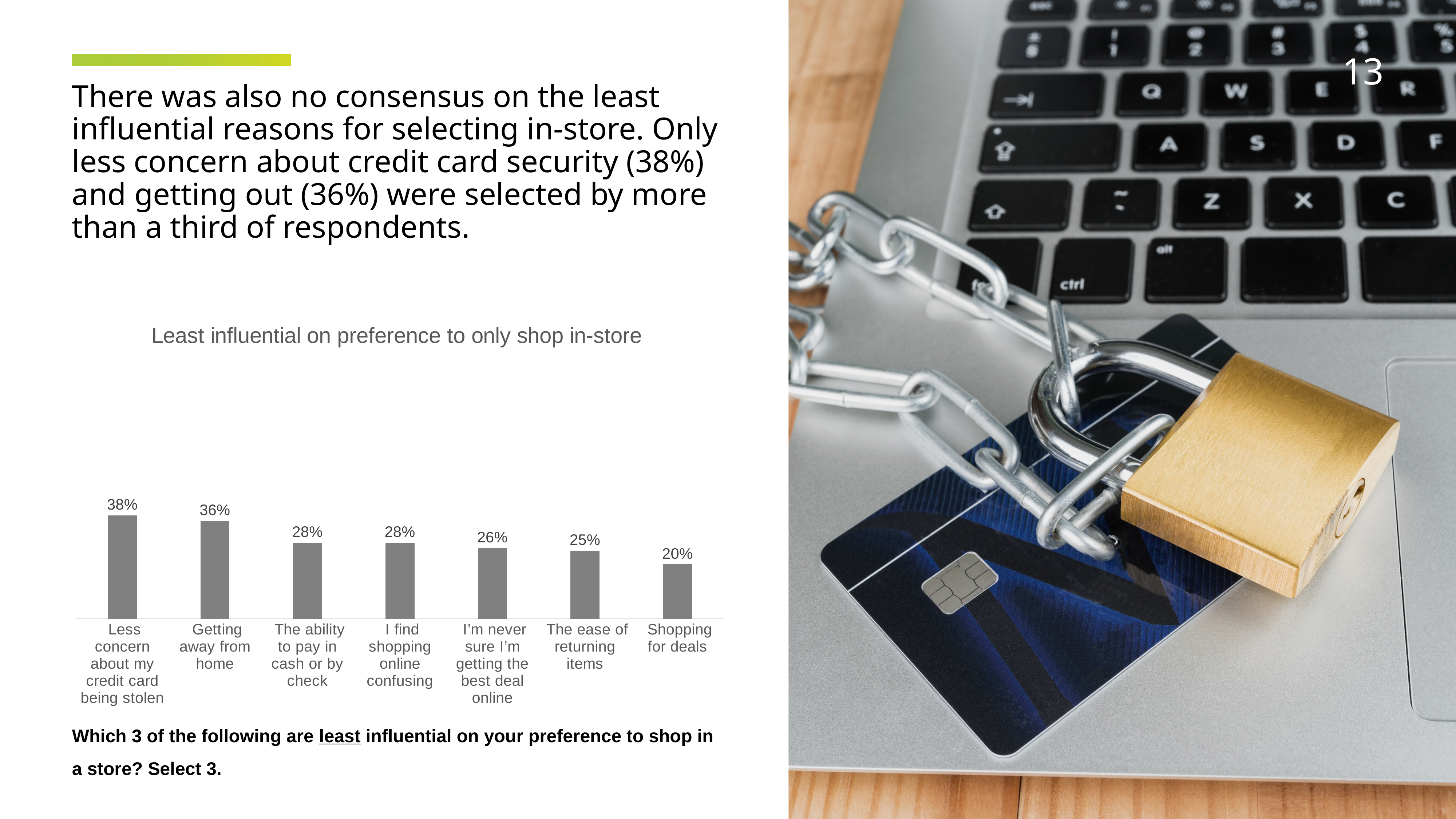
What is the value for "Less concern about my credit card being stolen"? 38% What is the value for "The ease of returning items"? 25% Do the values rise or fall from left to right along the x axis? Fall What is the value for "Getting away from home"? 36% What is the value for "Shopping for deals"? 20% What is the title of the chart? Least influential on preference to only shop in-store Which category has the highest value? Less concern about my credit card being stolen Which is larger: the value for "I'm never sure I'm getting the best deal online" or the value for "Shopping for deals"? I'm never sure I'm getting the best deal online Which category has the lowest value? Shopping for deals What kind of chart is shown on the slide? Bar chart What is the difference between the values for "Less concern about my credit card being stolen" and "Shopping for deals"? 18% How many categories are shown in the chart? 7